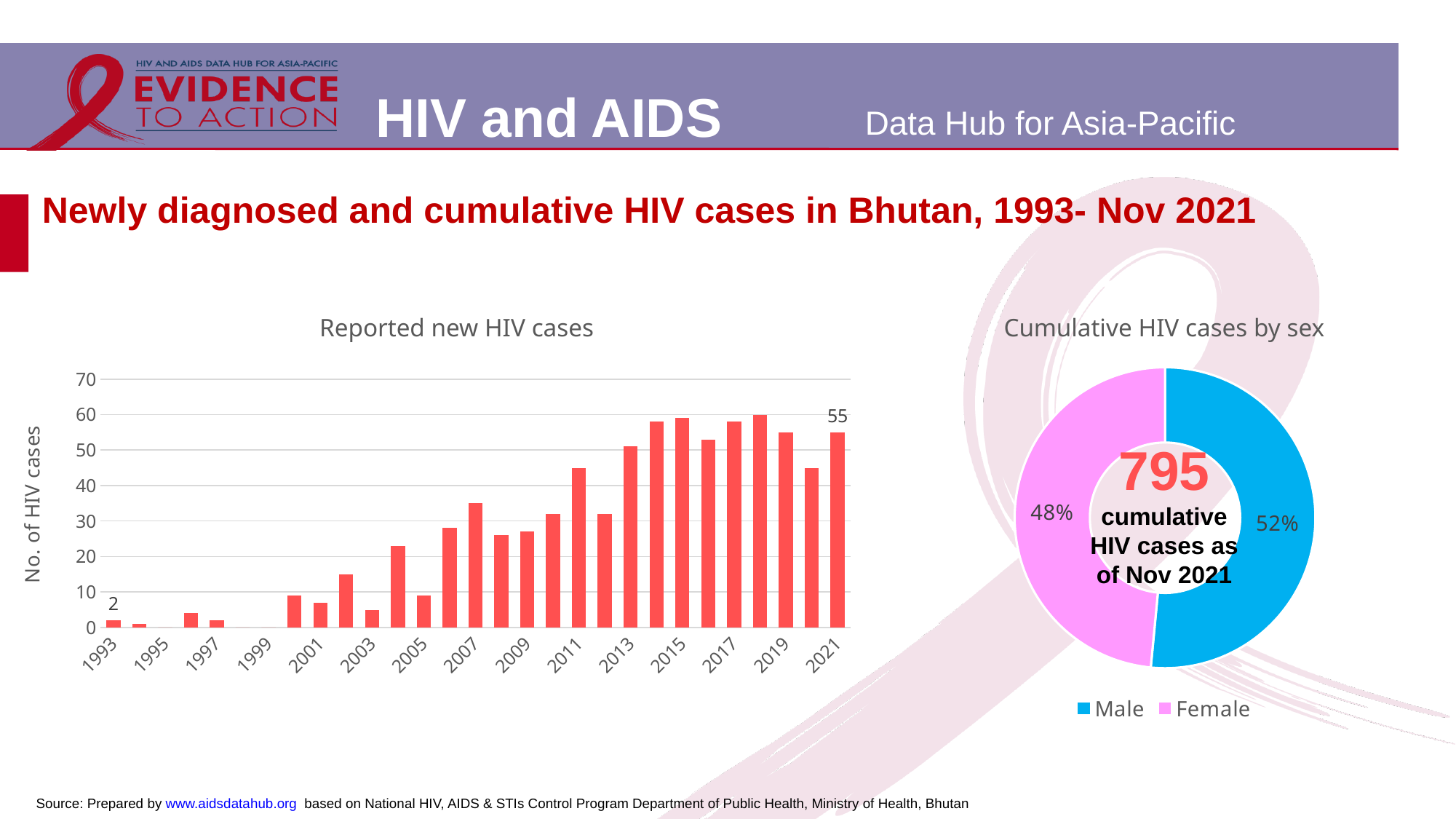
In the 'Cumulative HIV cases by sex' chart, what share of cumulative cases is Female? 48% In the 'Cumulative HIV cases by sex' chart, what is the total number of cumulative HIV cases as of Nov 2021? 795 In the 'Reported new HIV cases' chart, how many new HIV cases were reported in 1993? 2 In the 'Reported new HIV cases' chart, which year had more reported cases, 1993 or 2021? 2021 In the 'Reported new HIV cases' chart, is the value for 2011 greater or less than 50? less In the 'Reported new HIV cases' chart, is the value for 2007 greater or less than 30? greater In the 'Reported new HIV cases' chart, what is the difference between the number of cases in 2021 and in 1993? 53 In the 'Cumulative HIV cases by sex' chart, which group has the larger share, Male or Female? Male In the 'Reported new HIV cases' chart, is the value for 2003 greater or less than 10? less What kind of chart is 'Reported new HIV cases'? Bar chart In the 'Cumulative HIV cases by sex' chart, what share of cumulative cases is Male? 52% In the 'Reported new HIV cases' chart, how many new HIV cases were reported in 2021? 55